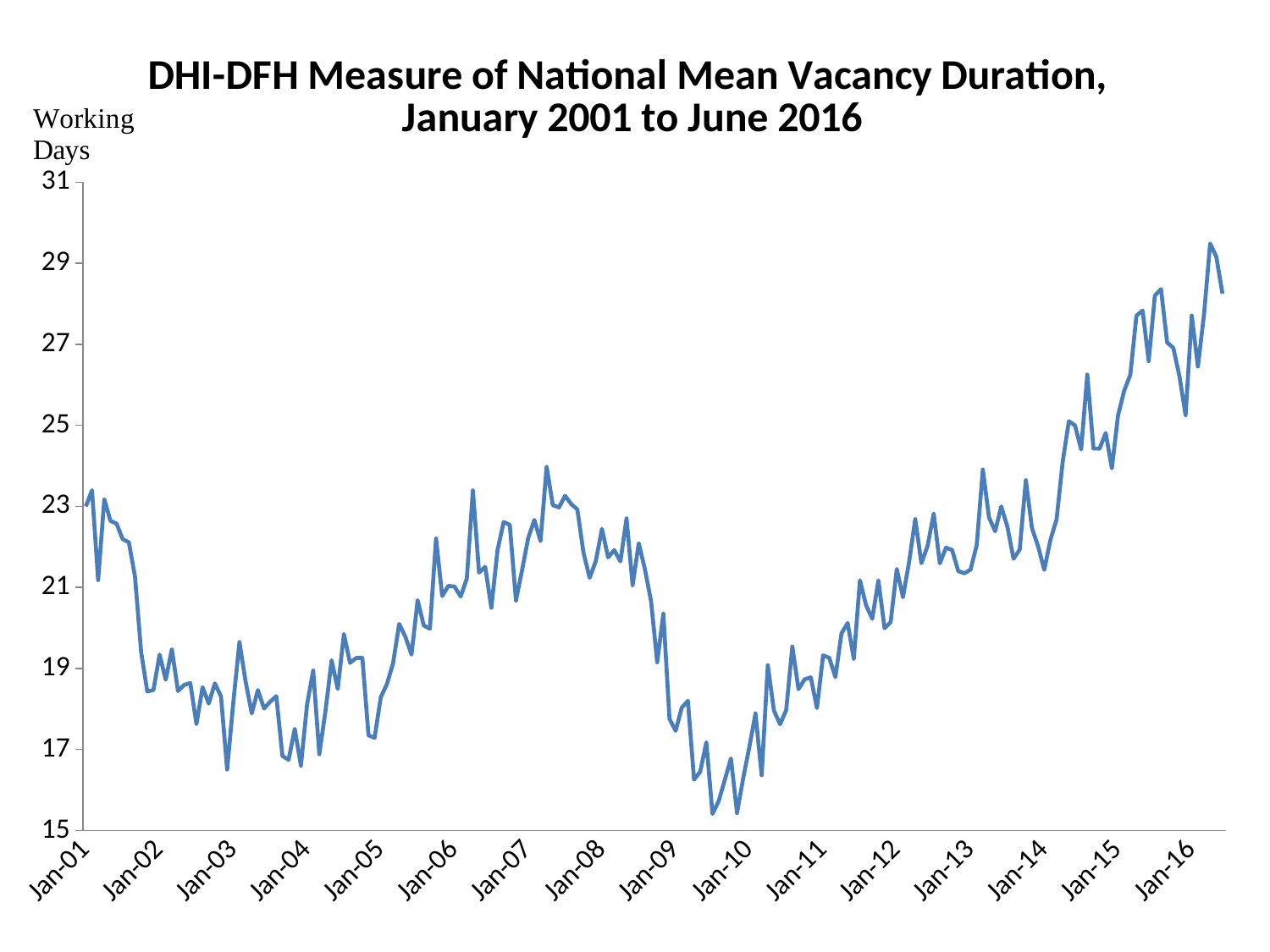
How many lines (data series) are plotted on the chart? 1 What is the title of the chart? DHI-DFH Measure of National Mean Vacancy Duration, January 2001 to June 2016 How many year labels (Jan-01 through Jan-16) are shown on the x axis? 16 Is the value at Jan-07 greater or less than 21? greater What kind of chart is shown on the slide? line chart What unit is shown on the vertical axis label? Working Days Is the value at Jan-04 greater or less than 19? less In which year does the line reach its highest point? 2016 Is the value at Jan-16 greater or less than 25? greater Does the line generally rise or fall between Jan-10 and Jan-16? rise